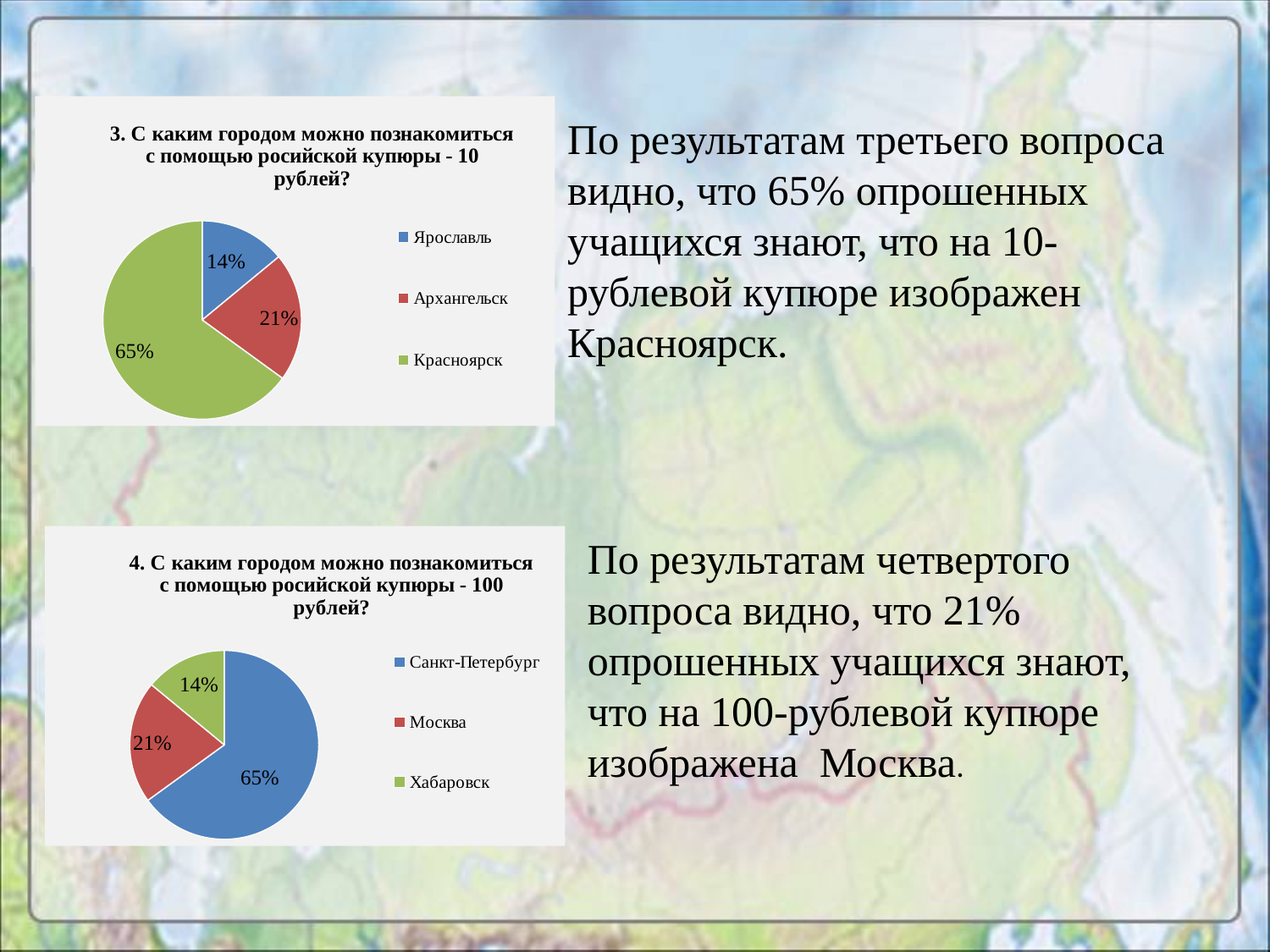
In the top chart (question 3, 10 rubles), what share is shown for Ярославль? 14% In the bottom chart (question 4, 100 rubles), what share is shown for Москва? 21% In the bottom chart (question 4, 100 rubles), what is the difference between the shares for Санкт-Петербург and Хабаровск? 51% In the top chart (question 3, 10 rubles), what is the difference between the shares for Архангельск and Ярославль? 7% In the bottom chart (question 4, 100 rubles), which city has the largest slice? Санкт-Петербург What kind of chart is the top chart on the slide? pie chart In the top chart (question 3, 10 rubles), which city has the smallest slice? Ярославль In the top chart (question 3, 10 rubles), which city has the largest slice? Красноярск How many slices does the top pie chart have? 3 In the bottom chart (question 4, 100 rubles), which is larger, the share for Москва or the share for Хабаровск? Москва In the bottom chart, what colour is the slice for Хабаровск? green In the top chart (question 3, 10 rubles), what share is shown for Красноярск? 65%